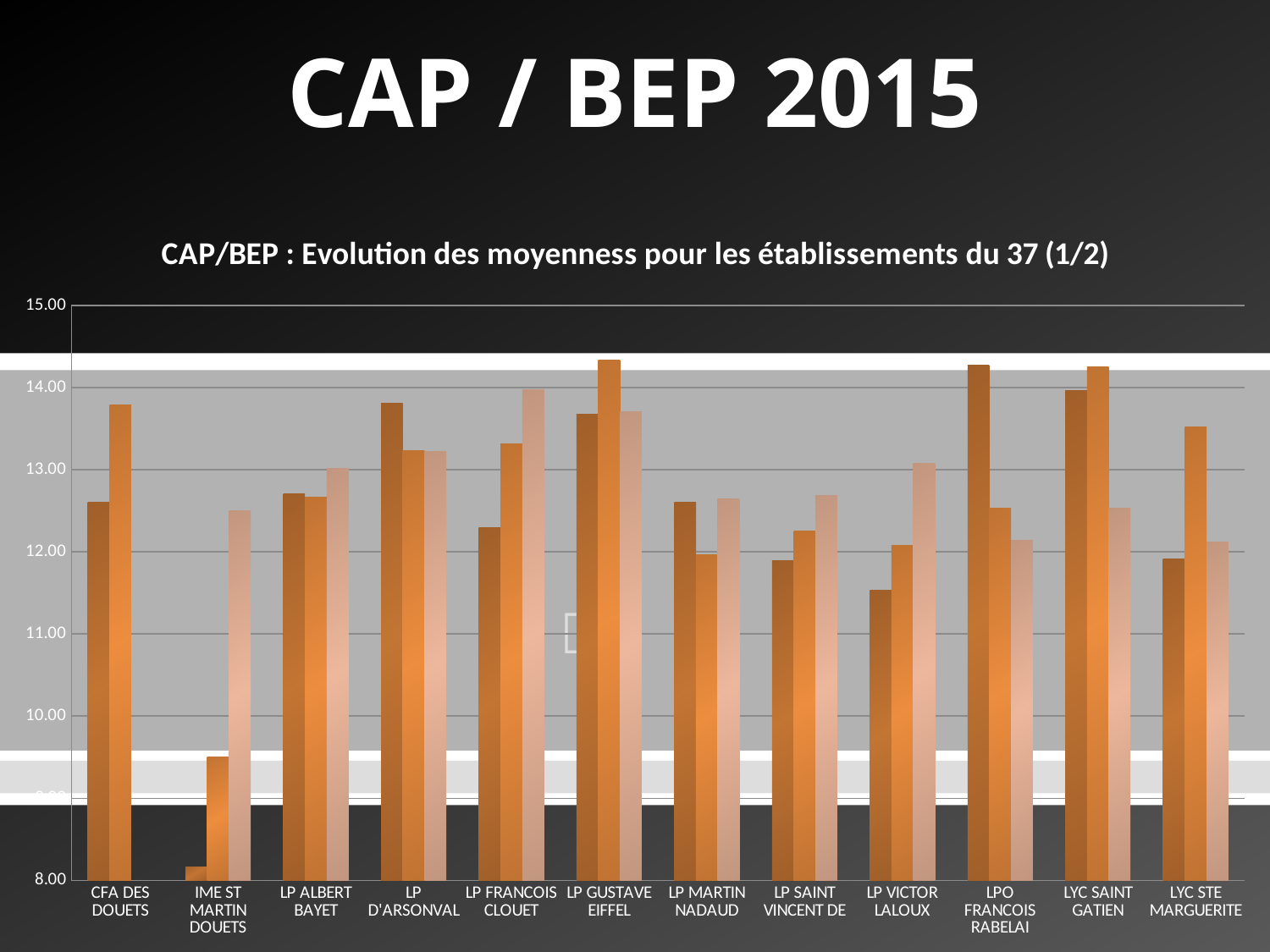
How many establishments (categories) are shown on the x axis of the chart? 12 Is the value of the first (leftmost) bar for IME ST MARTIN DOUETS greater or less than 9.00? less Which establishment has the lowest bar on the chart? IME ST MARTIN DOUETS Is the value of the second bar for CFA DES DOUETS greater or less than 13.00? greater What kind of chart is shown on the slide? bar chart For LP VICTOR LALOUX, which is larger: the first (leftmost) bar or the third bar? the third bar What is the title of the chart? CAP/BEP : Evolution des moyenness pour les établissements du 37 (1/2) Is the value of the second bar for IME ST MARTIN DOUETS greater or less than 10.00? less For IME ST MARTIN DOUETS, which is larger: the first (leftmost) bar or the third bar? the third bar